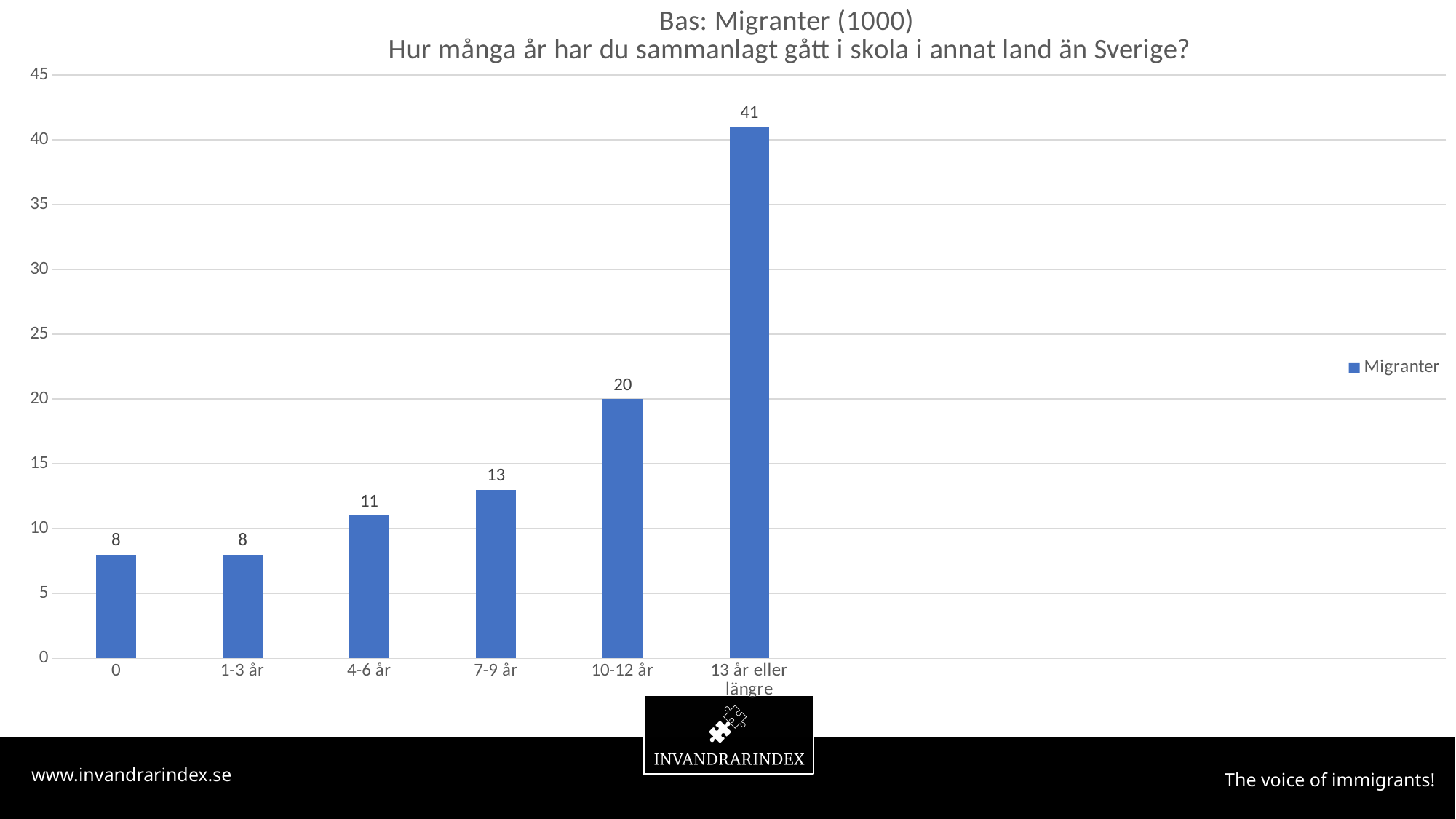
What is the difference between the values for "7-9 år" and "4-6 år"? 2 Which category has the highest value? 13 år eller längre What is the value for the "4-6 år" category? 11 What is the value for the "10-12 år" category? 20 What is the name of the series shown in the legend? Migranter What is the value for the "13 år eller längre" category? 41 How many series does the legend list? 1 How many categories are shown on the x axis? 6 What is the difference between the values for "13 år eller längre" and "10-12 år"? 21 Is the value for "10-12 år" greater or less than 15? greater What kind of chart is shown on the slide? Bar chart Which is larger, the value for "7-9 år" or the value for "1-3 år"? 7-9 år